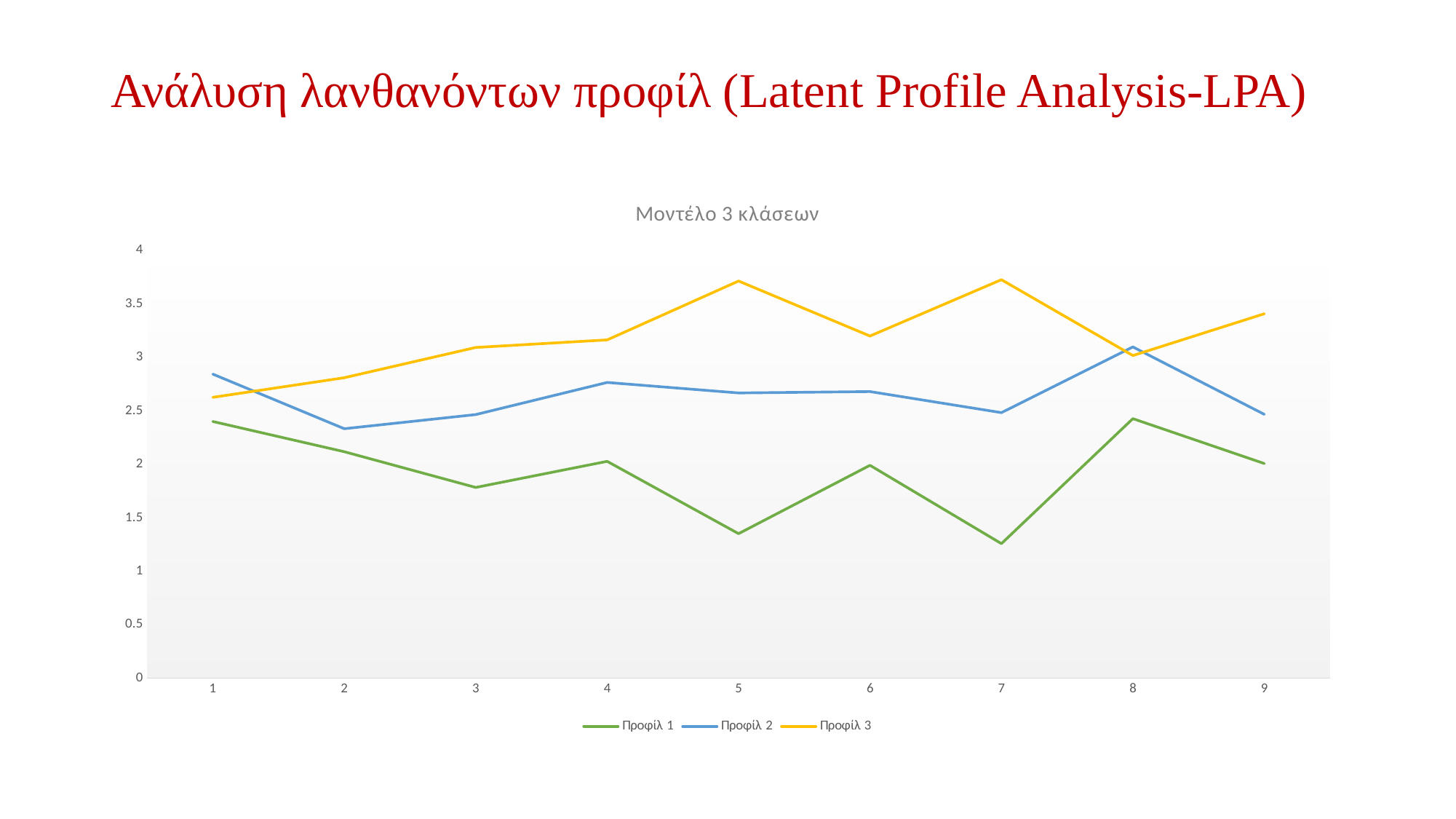
At which point does Προφίλ 2 reach its highest value? 8 Is the value for Προφίλ 3 at point 5 greater or less than 3.5? greater Does Προφίλ 3 rise or fall from point 1 to point 5? rise How many points are there along the x axis? 9 What kind of chart is shown on the slide? line chart Is the value for Προφίλ 2 at point 2 greater or less than 2.5? less At point 5, which is larger: Προφίλ 1 or Προφίλ 2? Προφίλ 2 What is the title of the chart? Μοντέλο 3 κλάσεων How many series does the legend list? 3 Which series has the highest value at point 9? Προφίλ 3 Is the value for Προφίλ 1 at point 7 greater or less than 1.5? less At point 1, which is larger: Προφίλ 2 or Προφίλ 3? Προφίλ 2